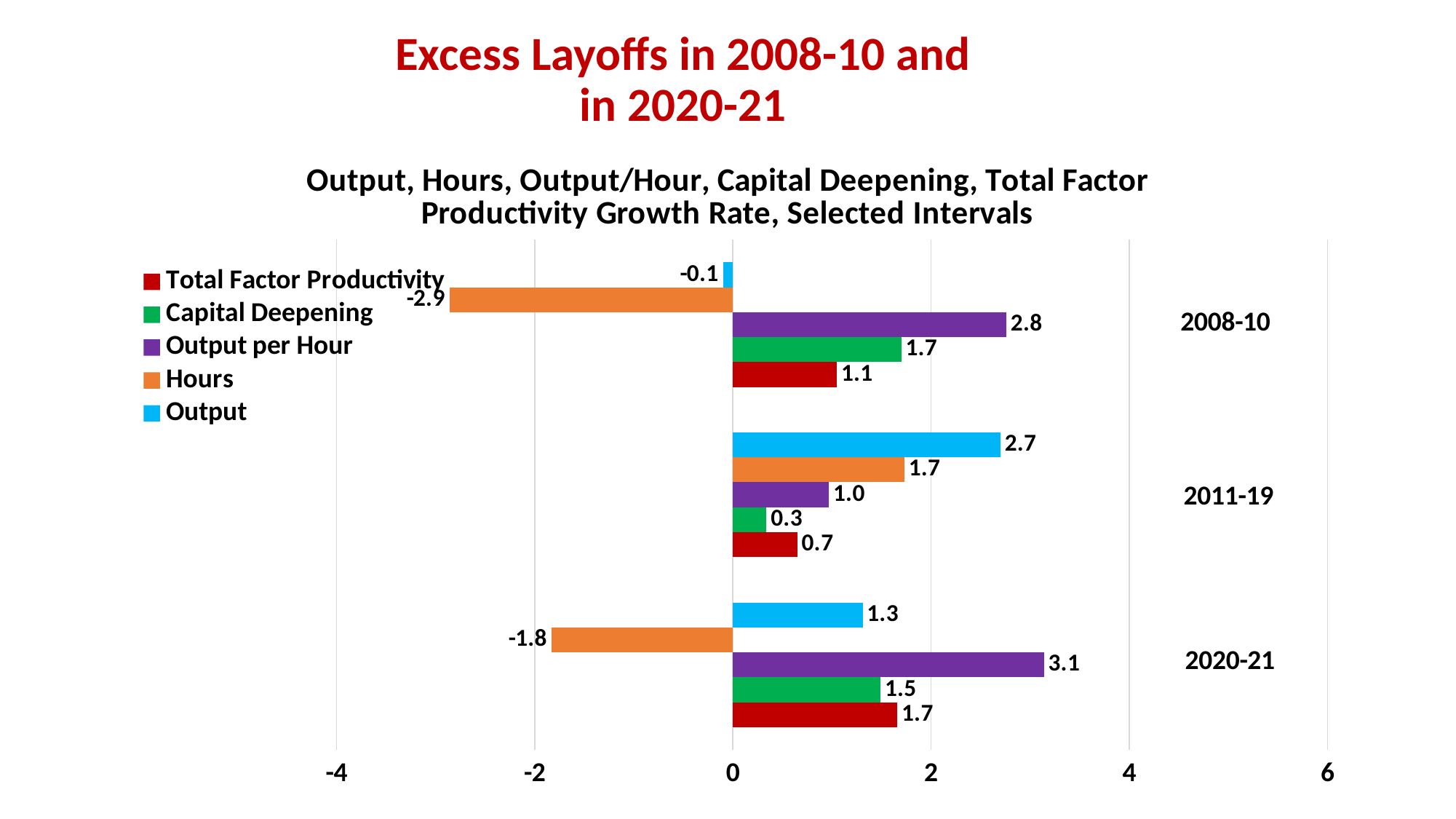
What is the value for Hours in 2008-10? -2.9 Which series has the lowest value in 2008-10? Hours What is the difference between Output per Hour in 2020-21 and Output per Hour in 2008-10? 0.3 What is the value for Output per Hour in 2020-21? 3.1 What colour represents Hours in the chart? Orange Which series has the highest value in 2020-21? Output per Hour What kind of chart is shown on the slide? Bar chart How many time intervals are shown on the chart? 3 How many series does the legend list? 5 Which is larger: Total Factor Productivity in 2020-21 or Total Factor Productivity in 2011-19? Total Factor Productivity in 2020-21 What is the value for Output in 2011-19? 2.7 What is the value for Capital Deepening in 2011-19? 0.3